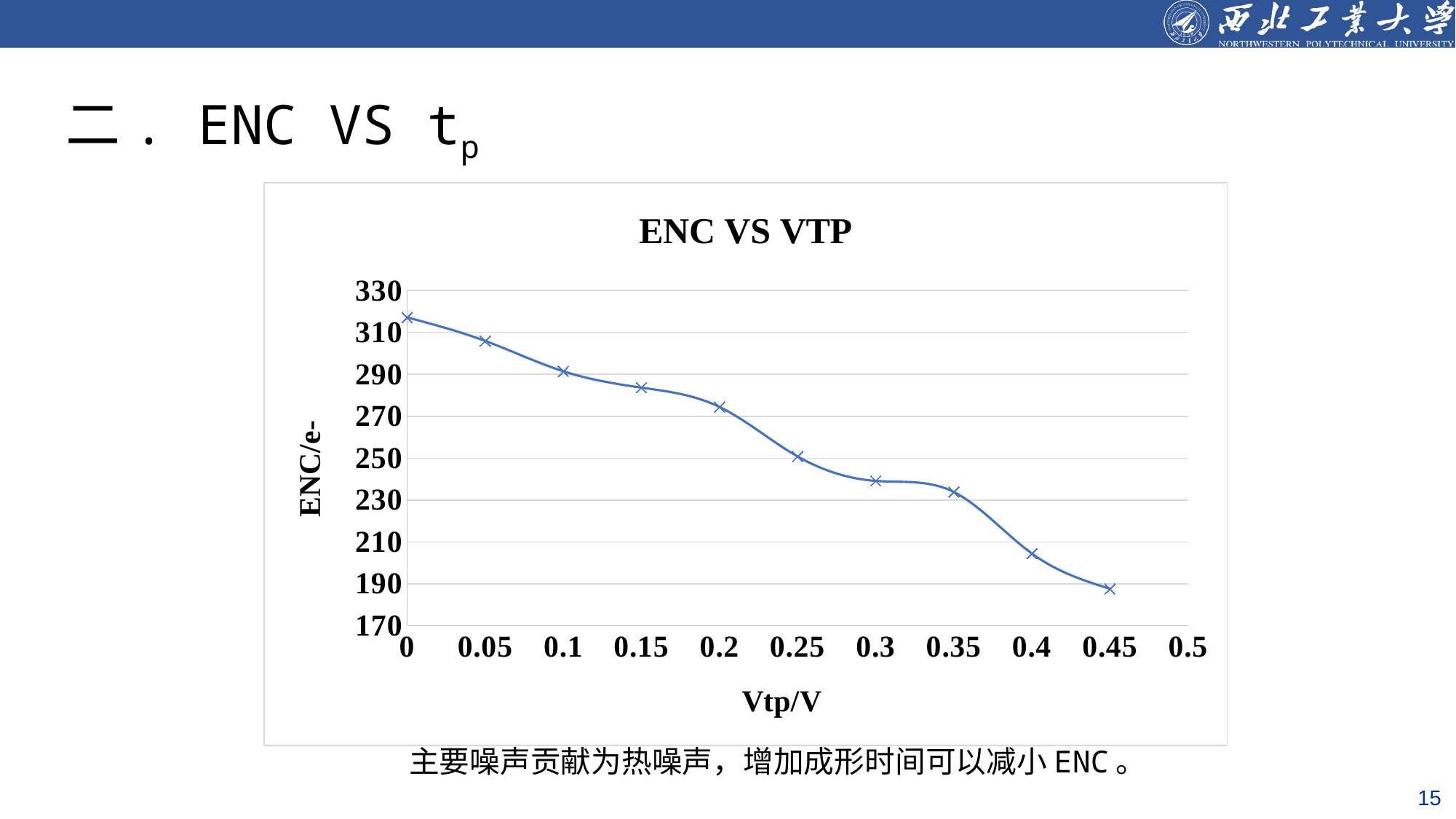
How many data points are plotted on the chart? 10 At which Vtp value is ENC lowest? 0.45 Is the ENC value at Vtp = 0.4 greater or less than 210? less Is the ENC value at Vtp = 0 greater or less than 310? greater What is the label of the y axis of the chart? ENC/e- Is the ENC value at Vtp = 0.15 greater or less than 290? less What kind of chart is shown on the slide? line chart Do the ENC values rise or fall as Vtp increases along the x axis? fall What is the title of the chart? ENC VS VTP Which has the larger ENC value, Vtp = 0.2 or Vtp = 0.35? 0.2 At which Vtp value is ENC highest? 0